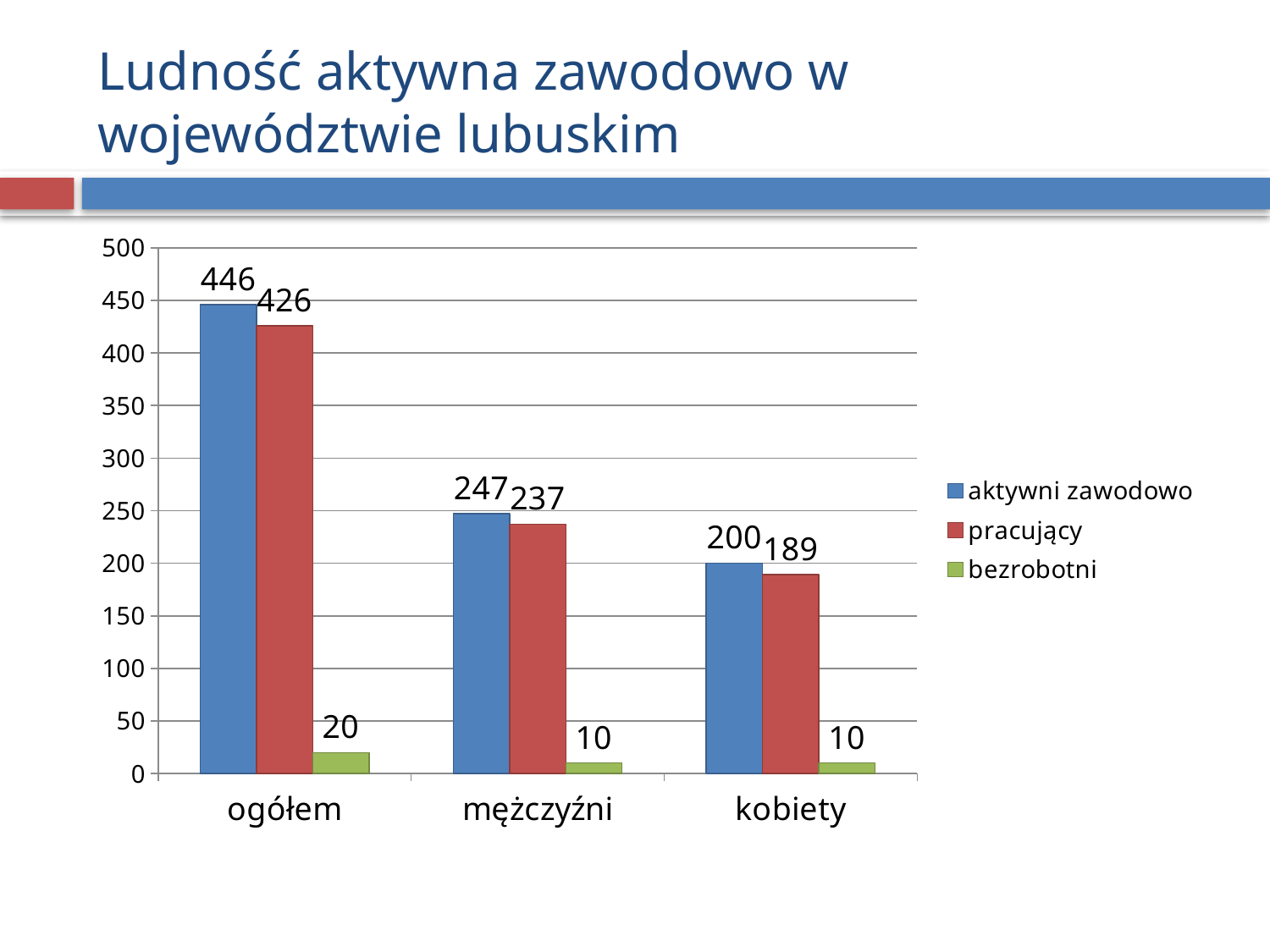
How many categories are shown on the x axis? 3 Which colour represents the 'bezrobotni' series? green What is the difference between 'aktywni zawodowo' for 'mężczyźni' and for 'kobiety'? 47 What is the value of 'pracujący' for 'kobiety'? 189 What kind of chart is shown on the slide? bar chart What is the difference between 'aktywni zawodowo' and 'pracujący' for 'ogółem'? 20 Which category has the lowest value for 'aktywni zawodowo'? kobiety How many series does the legend list? 3 Which is larger: 'pracujący' for 'mężczyźni' or 'pracujący' for 'kobiety'? mężczyźni What is the value of 'aktywni zawodowo' for 'ogółem'? 446 What is the value of 'bezrobotni' for 'mężczyźni'? 10 Which category has the highest value for 'pracujący'? ogółem